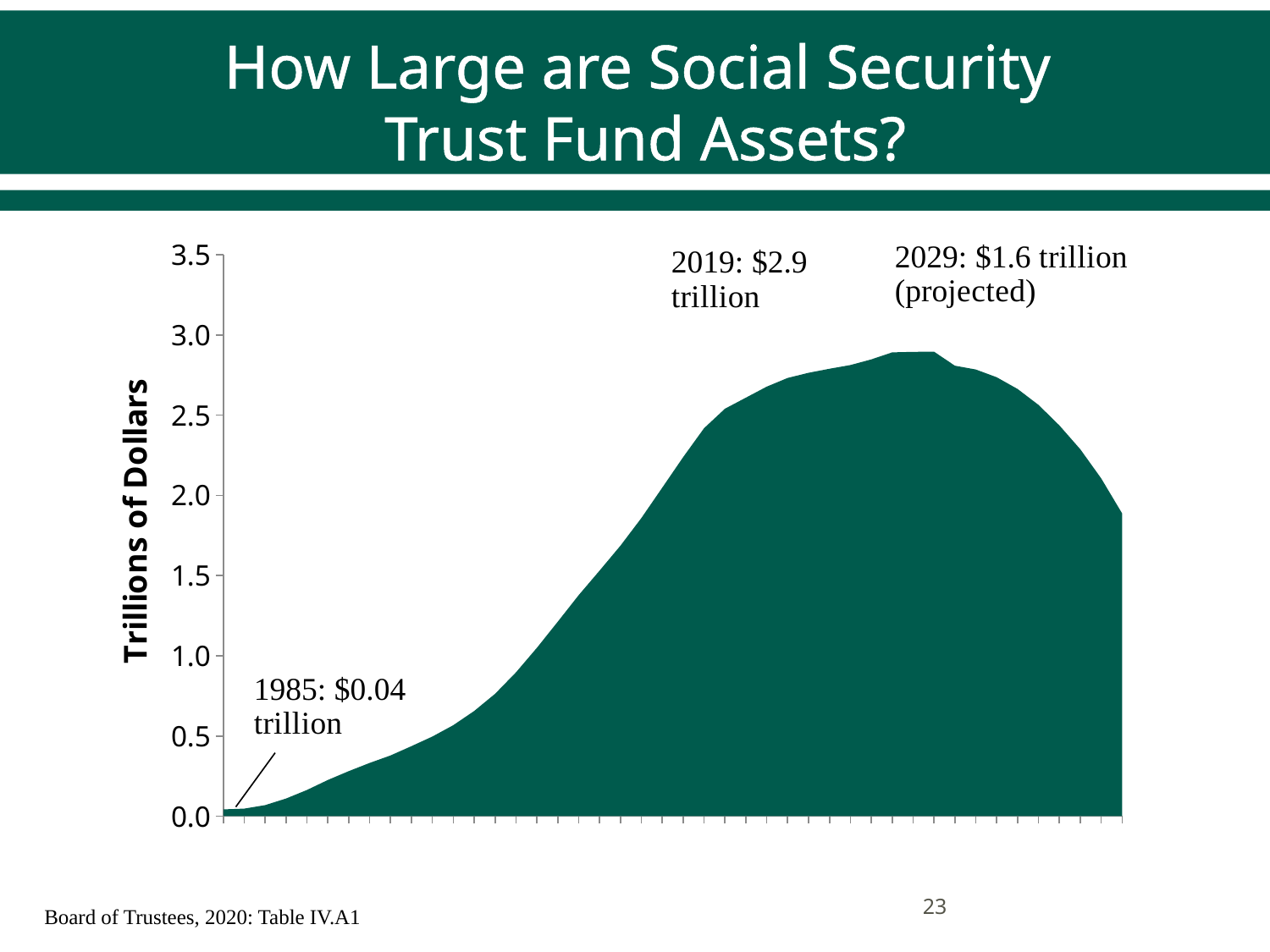
What is the label on the vertical axis of the chart? Trillions of Dollars What were Social Security trust fund assets in 1985 according to the chart? $0.04 trillion What kind of chart is shown on the slide? Area chart Of the three labeled years (1985, 2019, 2029), which has the lowest trust fund assets? 1985 Of the three labeled years (1985, 2019, 2029), which has the highest trust fund assets? 2019 Is the peak value of the area greater or less than 2.5 trillion dollars? greater What were Social Security trust fund assets in 2019 according to the chart? $2.9 trillion Which is larger: trust fund assets in 2019 or projected assets in 2029? 2019 By how much do the labeled 2019 assets exceed the projected 2029 assets? $1.3 trillion Is the peak value of the area greater or less than 3.0 trillion dollars? less How do trust fund assets change over time in the chart? They rise to a peak and then fall What are the projected Social Security trust fund assets for 2029? $1.6 trillion